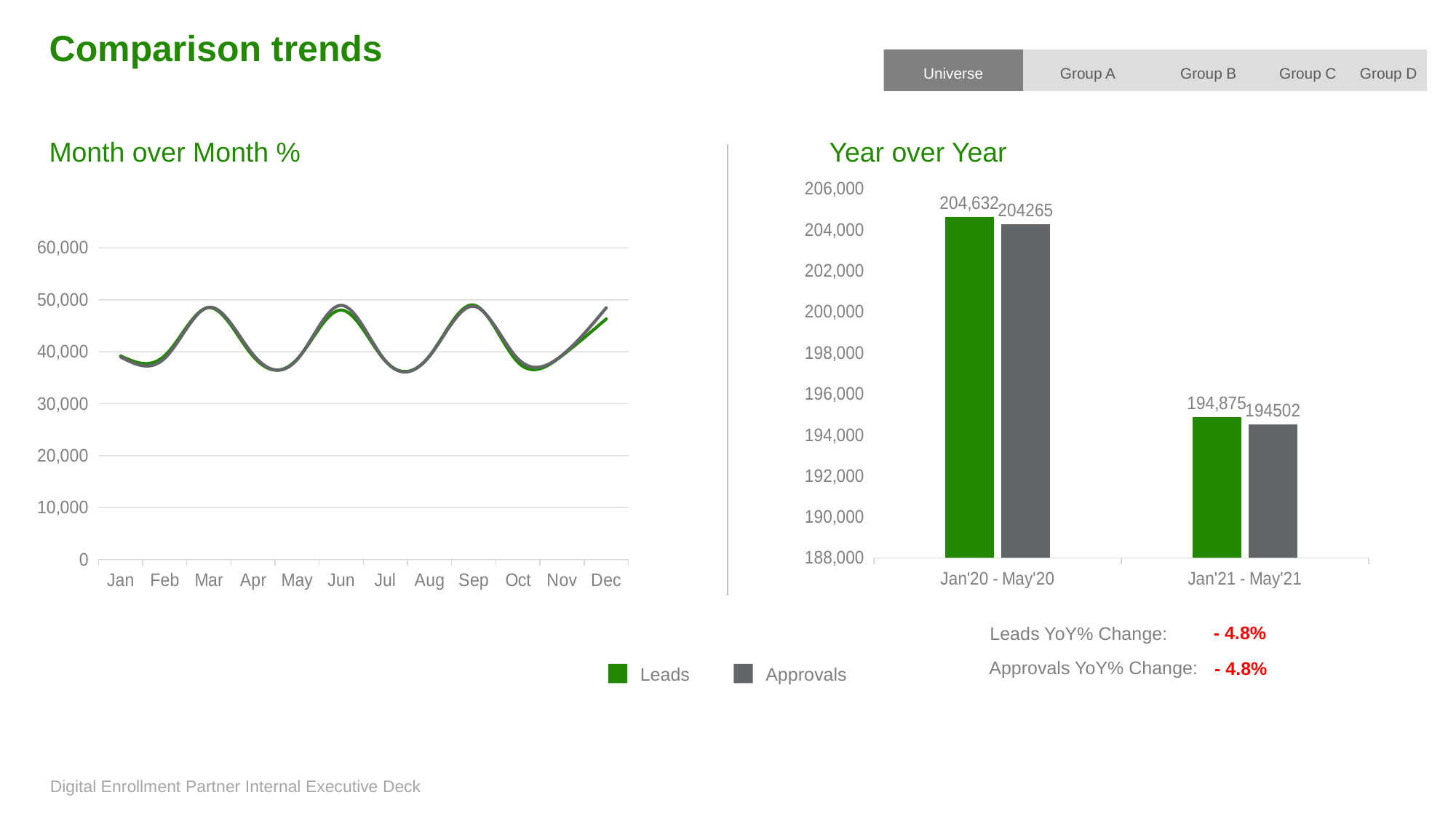
In the Year over Year chart, which is larger for Jan'21 - May'21, Leads or Approvals? Leads What kind of chart is the Month over Month % chart? line chart In the Year over Year chart, which period has the lowest Leads value? Jan'21 - May'21 In the Month over Month % chart, is the Leads value for Apr greater or less than 40,000? less How many months are shown on the x axis of the Month over Month % chart? 12 In the Year over Year chart, what is the Approvals value for Jan'20 - May'20? 204265 What kind of chart is the Year over Year chart? bar chart In the Year over Year chart, what is the Leads value for Jan'20 - May'20? 204,632 How many series does the legend list? 2 In the Year over Year chart, what is the difference between the Leads values for Jan'20 - May'20 and Jan'21 - May'21? 9,757 In the Year over Year chart, what is the Approvals value for Jan'21 - May'21? 194502 In the Month over Month % chart, do the Leads values rise or fall from Jan to Mar? rise